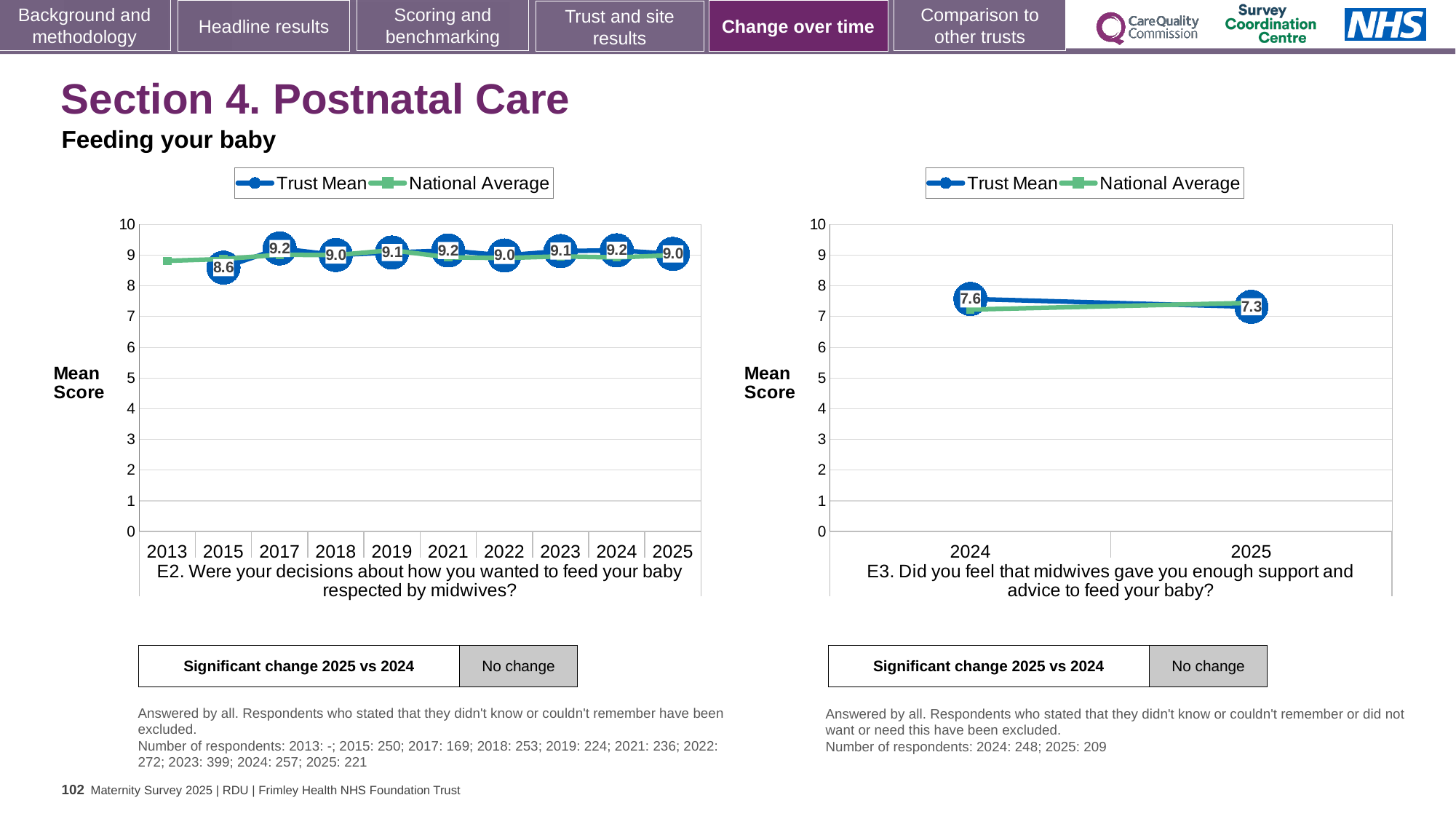
In the E2 chart on the left, what is the difference between the Trust Mean for 2025 and 2015? 0.4 In the E2 chart on the left, is the Trust Mean higher in 2017 or in 2015? 2017 In the E2 chart on the left, what is the Trust Mean for 2025? 9.0 In the E2 chart on the left, which year has the lowest Trust Mean? 2015 In the E2 chart on the left, what is the Trust Mean for 2015? 8.6 In the E3 chart on the right, does the Trust Mean rise or fall from 2024 to 2025? fall In the E3 chart on the right, what is the Trust Mean for 2024? 7.6 In the E3 chart on the right, what is the Trust Mean for 2025? 7.3 What kind of chart is the E3 chart on the right? line chart In the E3 chart on the right, what is the difference between the Trust Mean for 2024 and 2025? 0.3 How many years are shown on the x axis of the E2 chart on the left? 10 How many series does the legend of the E3 chart on the right list? 2